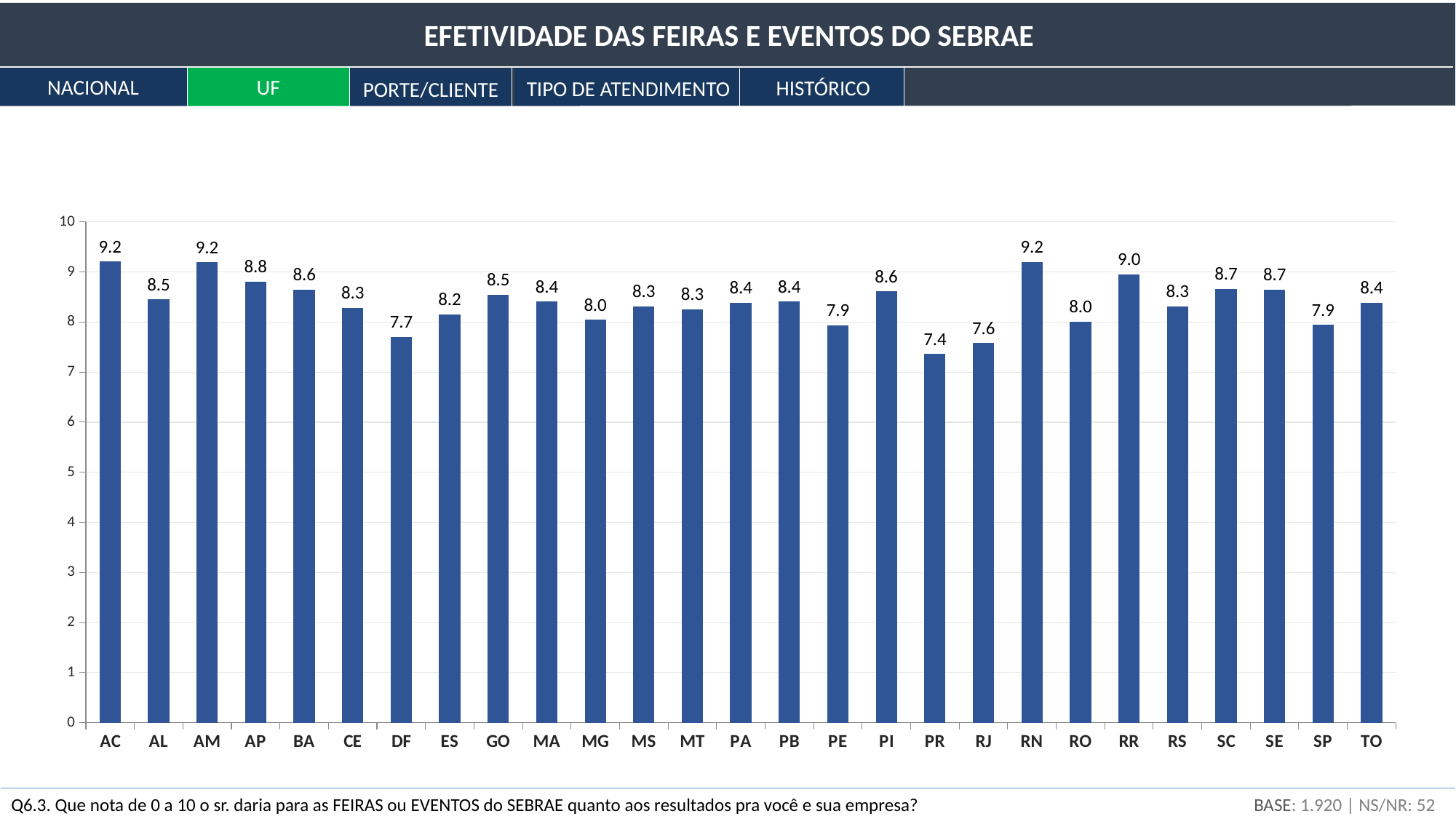
How many states are shown on the x axis? 27 What kind of chart is shown on the slide? Bar chart What is the value for SP? 7.9 What is the value for RR? 9.0 Which is larger, the value for AP or the value for PE? AP Which tab is highlighted in green at the top of the slide? UF What is the value for DF? 7.7 What is the value for PI? 8.6 Which state has the lowest value? PR What is the difference between the values for RR and DF? 1.3 Which is larger, the value for RR or the value for RJ? RR What is the difference between the values for AC and PR? 1.8